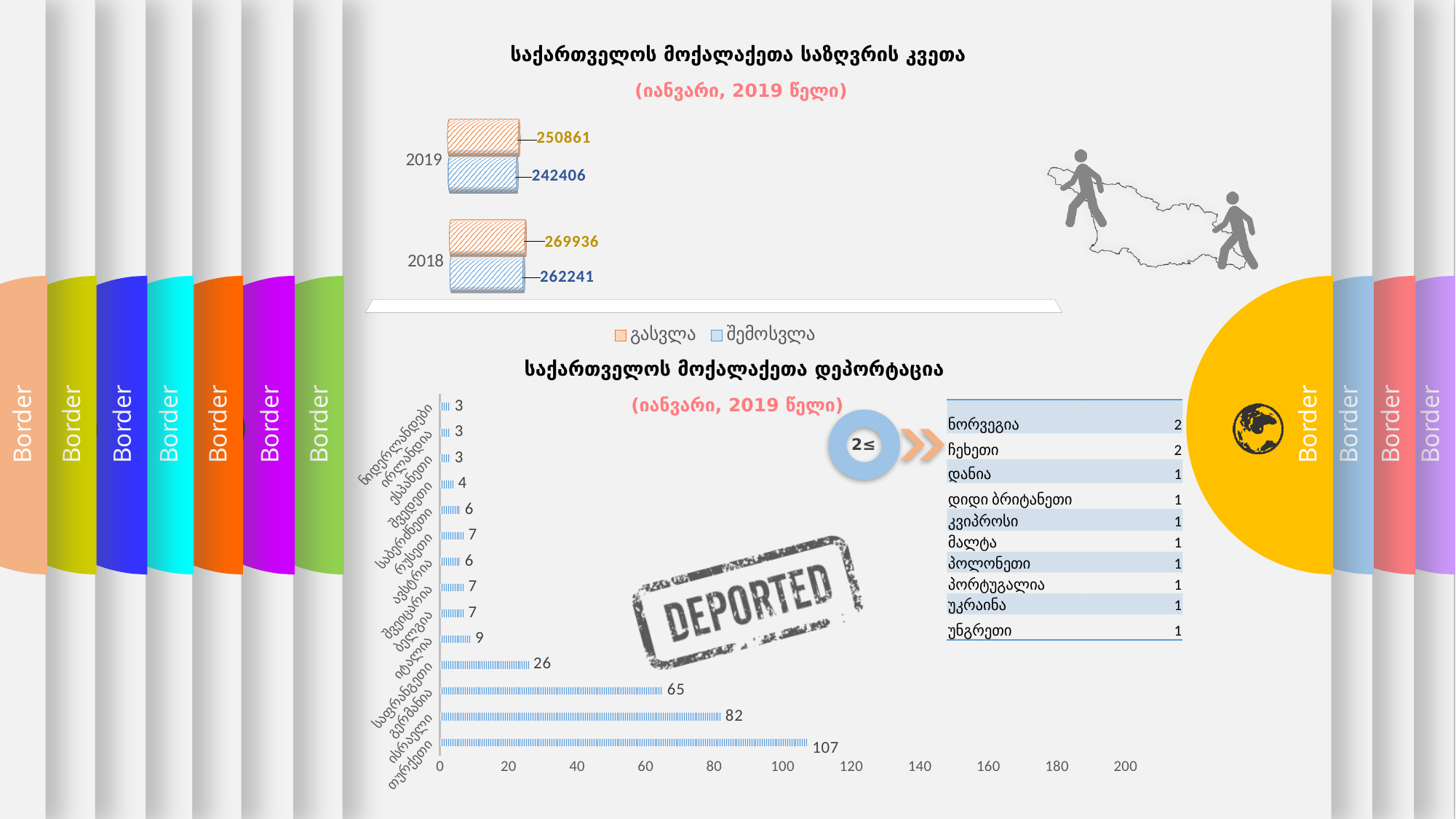
In the bottom chart (საქართველოს მოქალაქეთა დეპორტაცია), how many countries are plotted? 14 In the top chart (საქართველოს მოქალაქეთა საზღვრის კვეთა), which year has the larger შემოსვლა value, 2018 or 2019? 2018 In the top chart (საქართველოს მოქალაქეთა საზღვრის კვეთა), how many series does the legend list? 2 In the bottom chart (საქართველოს მოქალაქეთა დეპორტაცია), what is the difference between the values for თურქეთი and ისრაელი? 25 In the top chart (საქართველოს მოქალაქეთა საზღვრის კვეთა), what is the difference between გასვლა in 2018 and გასვლა in 2019? 19075 In the bottom chart (საქართველოს მოქალაქეთა დეპორტაცია), what is the value for გერმანია? 65 In the bottom chart (საქართველოს მოქალაქეთა დეპორტაცია), what is the value for ისრაელი? 82 In the top chart (საქართველოს მოქალაქეთა საზღვრის კვეთა), what is the value of გასვლა for 2019? 250861 In the top chart (საქართველოს მოქალაქეთა საზღვრის კვეთა), what is the total of the 2019 stacked bar (გასვლა plus შემოსვლა)? 493267 In the top chart (საქართველოს მოქალაქეთა საზღვრის კვეთა), what is the value of შემოსვლა for 2018? 262241 What kind of chart is the bottom chart (საქართველოს მოქალაქეთა დეპორტაცია)? bar chart In the bottom chart (საქართველოს მოქალაქეთა დეპორტაცია), which country has the highest value? თურქეთი